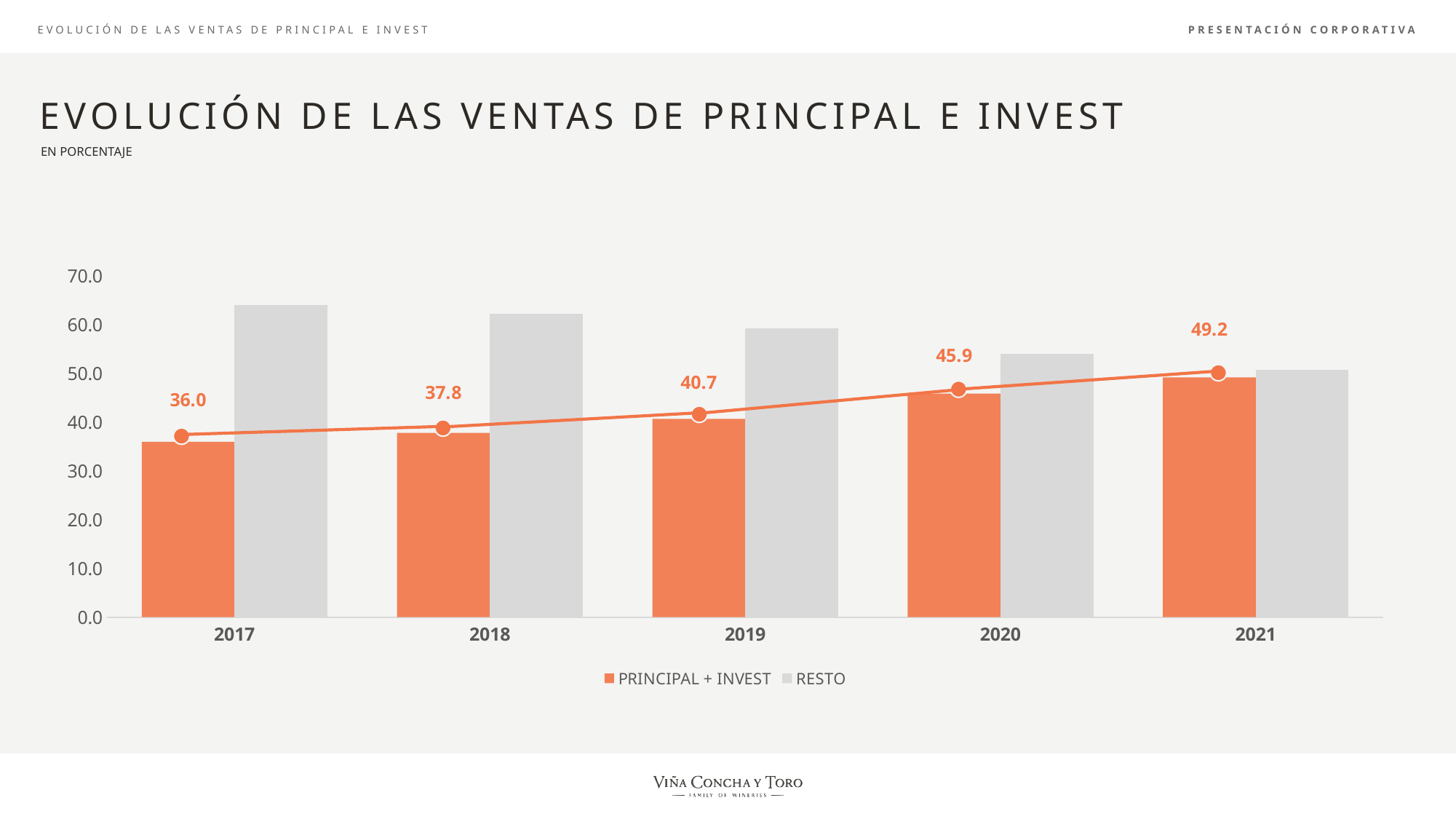
What is the value for PRINCIPAL + INVEST in 2019? 40.7 What is the difference between the PRINCIPAL + INVEST values for 2021 and 2017? 13.2 In which year is the PRINCIPAL + INVEST value highest? 2021 How many years are shown on the x axis? 5 Which is larger in 2020: PRINCIPAL + INVEST or RESTO? RESTO How many series does the legend list? 2 Does the PRINCIPAL + INVEST value rise or fall from 2017 to 2021? rise What is the value for PRINCIPAL + INVEST in 2017? 36.0 What is the value for PRINCIPAL + INVEST in 2021? 49.2 Is the value for RESTO in 2021 greater or less than 60.0? less In which year is the PRINCIPAL + INVEST value lowest? 2017 Is the value for RESTO in 2017 greater or less than 60.0? greater